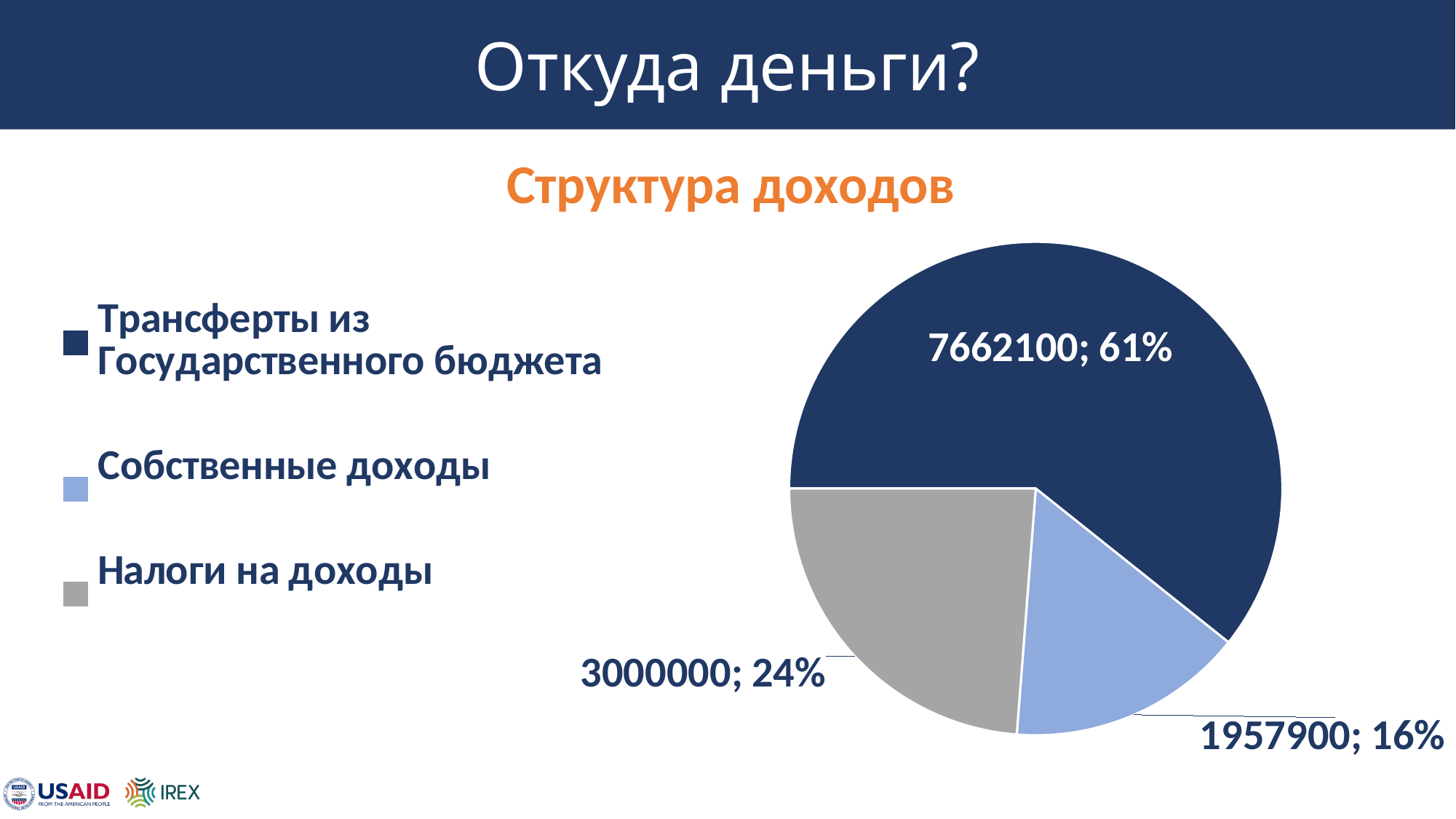
What share of the pie does Налоги на доходы represent? 24% Which category has the smallest slice? Собственные доходы What share of the pie does Трансферты из Государственного бюджета represent? 61% How many slices does the pie chart have? 3 What is the difference between the values for Налоги на доходы and Собственные доходы? 1042100 What is the value for Собственные доходы? 1957900 What is the value for Налоги на доходы? 3000000 What is the title of the chart? Структура доходов Which is larger, Налоги на доходы or Собственные доходы? Налоги на доходы What kind of chart is shown on the slide? Pie chart Which category has the largest slice? Трансферты из Государственного бюджета What is the value for Трансферты из Государственного бюджета? 7662100